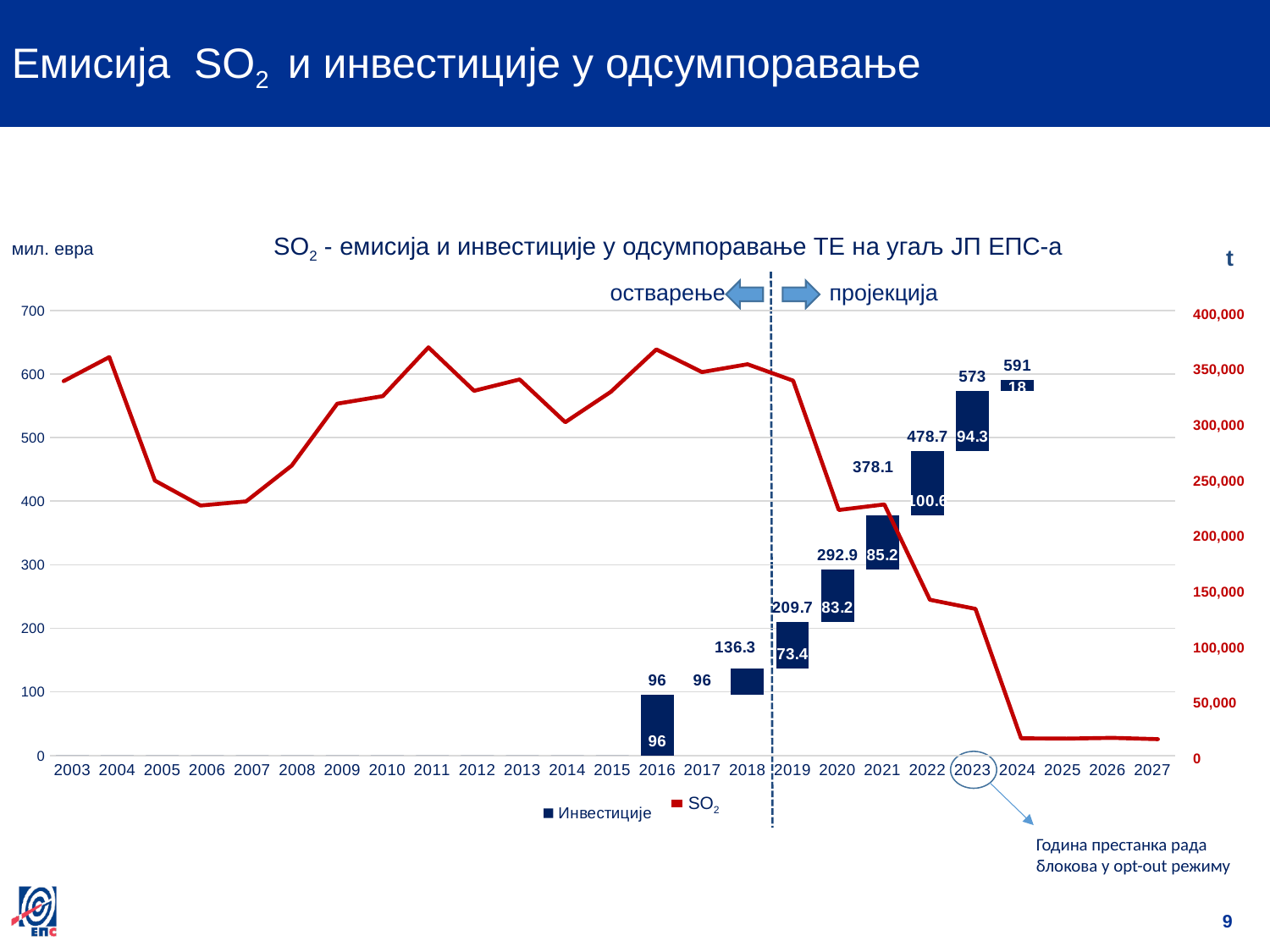
What is the cumulative investment value labelled above the bar for 2022? 478.7 Which is larger: the value inside the bar for 2021 (85.2) or the value inside the bar for 2020 (83.2)? 2021 (85.2) Does the SO2 line rise or fall between 2019 and 2024? Falls What kind of chart is this? Combined bar and line chart What unit is shown for the left axis? мил. евра What value is printed inside the investment bar for 2019? 73.4 What is the value labelled for 2018? 136.3 What is the value labelled above the bar for 2024? 591 How many series does the legend list? 2 What is the difference between the labelled values for 2024 (591) and 2023 (573)? 18 How many years are shown on the x axis? 25 Is the SO2 value for 2006 greater or less than 250,000? less